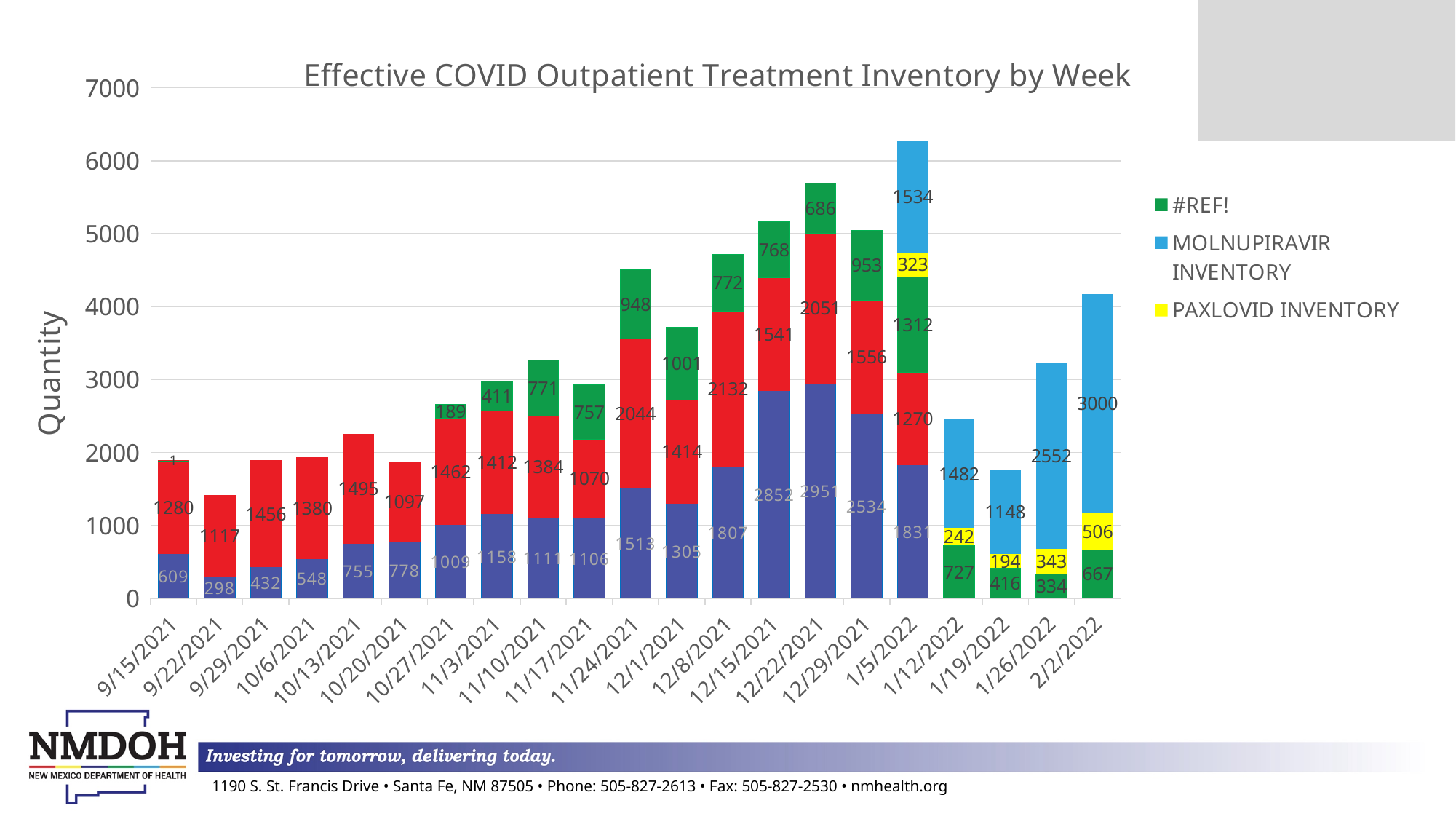
What is the MOLNUPIRAVIR INVENTORY value for the week of 2/2/2022? 3000 How many weeks are shown on the x axis? 21 Which week has the larger PAXLOVID INVENTORY value, 1/5/2022 or 1/26/2022? 1/26/2022 What kind of chart is shown on the slide? Stacked bar chart Which week has the highest MOLNUPIRAVIR INVENTORY value? 2/2/2022 What is the total of the stacked bar for 1/12/2022 (MOLNUPIRAVIR INVENTORY, PAXLOVID INVENTORY and #REF! combined)? 2451 Is the total height of the stacked bar for 1/5/2022 greater or less than 6000? greater Which week has the lowest PAXLOVID INVENTORY value? 1/19/2022 What is the difference between the MOLNUPIRAVIR INVENTORY values for 2/2/2022 and 1/26/2022? 448 How many series does the legend list? 3 What is the PAXLOVID INVENTORY value for the week of 1/19/2022? 194